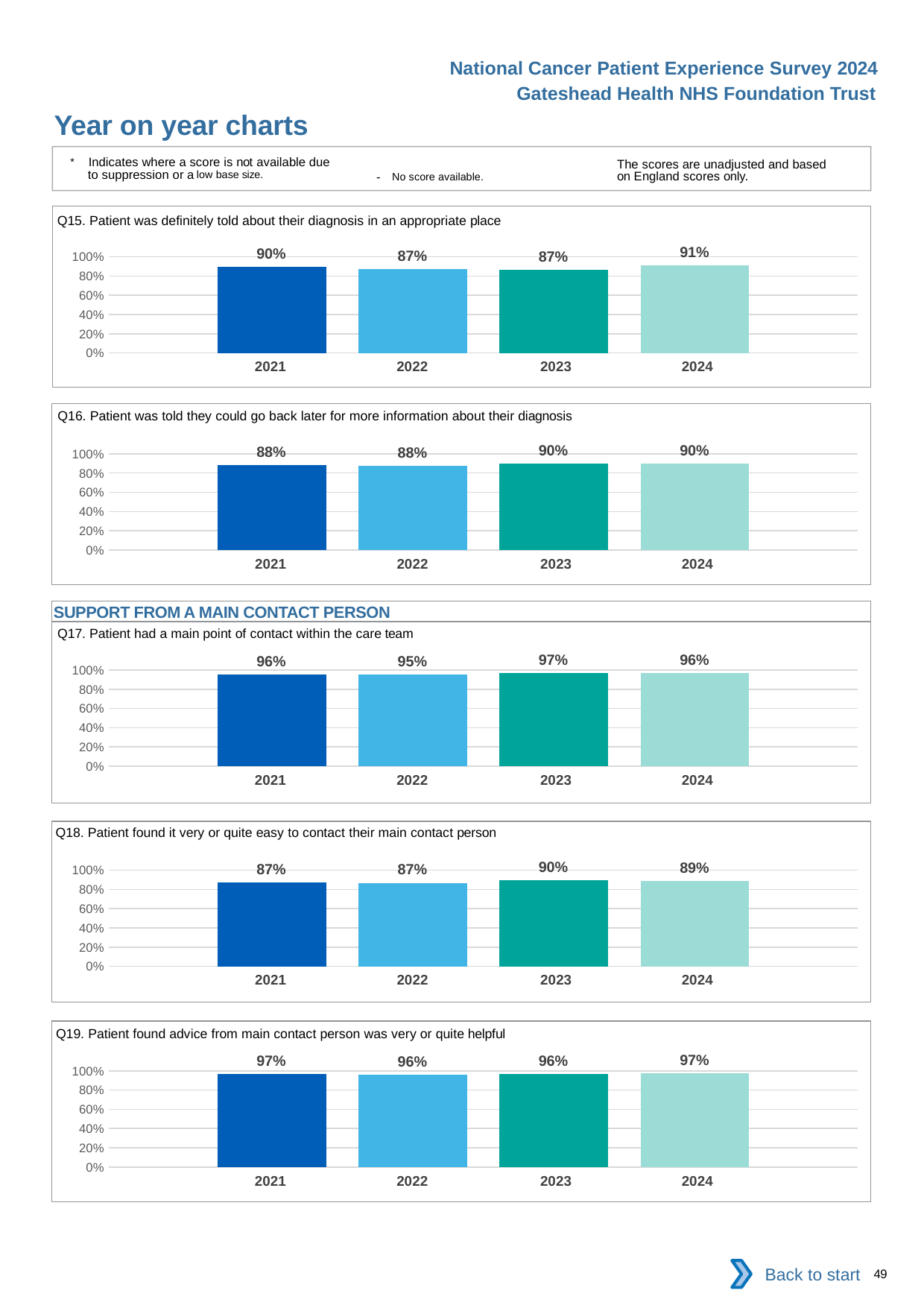
In the Q18 chart (patient found it very or quite easy to contact their main contact person), what is the value for 2023? 90% In the Q15 chart (patient was definitely told about their diagnosis in an appropriate place), what is the value for 2024? 91% In the Q17 chart (patient had a main point of contact within the care team), which year has the highest value? 2023 In the Q19 chart, what is the difference between the 2021 value and the 2022 value? 1 percentage point In the Q18 chart, which is larger, the value for 2021 or the value for 2024? 2024 In the Q19 chart (patient found advice from main contact person was very or quite helpful), what is the value for 2021? 97% In the Q17 chart, what is the value for 2022? 95% In the Q15 chart, which year has the lowest value? 2022 and 2023 What kind of chart is used for Q18? Bar chart In the Q16 chart (patient was told they could go back later for more information), what is the value for 2021? 88% In the Q16 chart, what is the difference between the 2023 value and the 2022 value? 2 percentage points How many years are shown on the x axis of the Q15 chart? 4